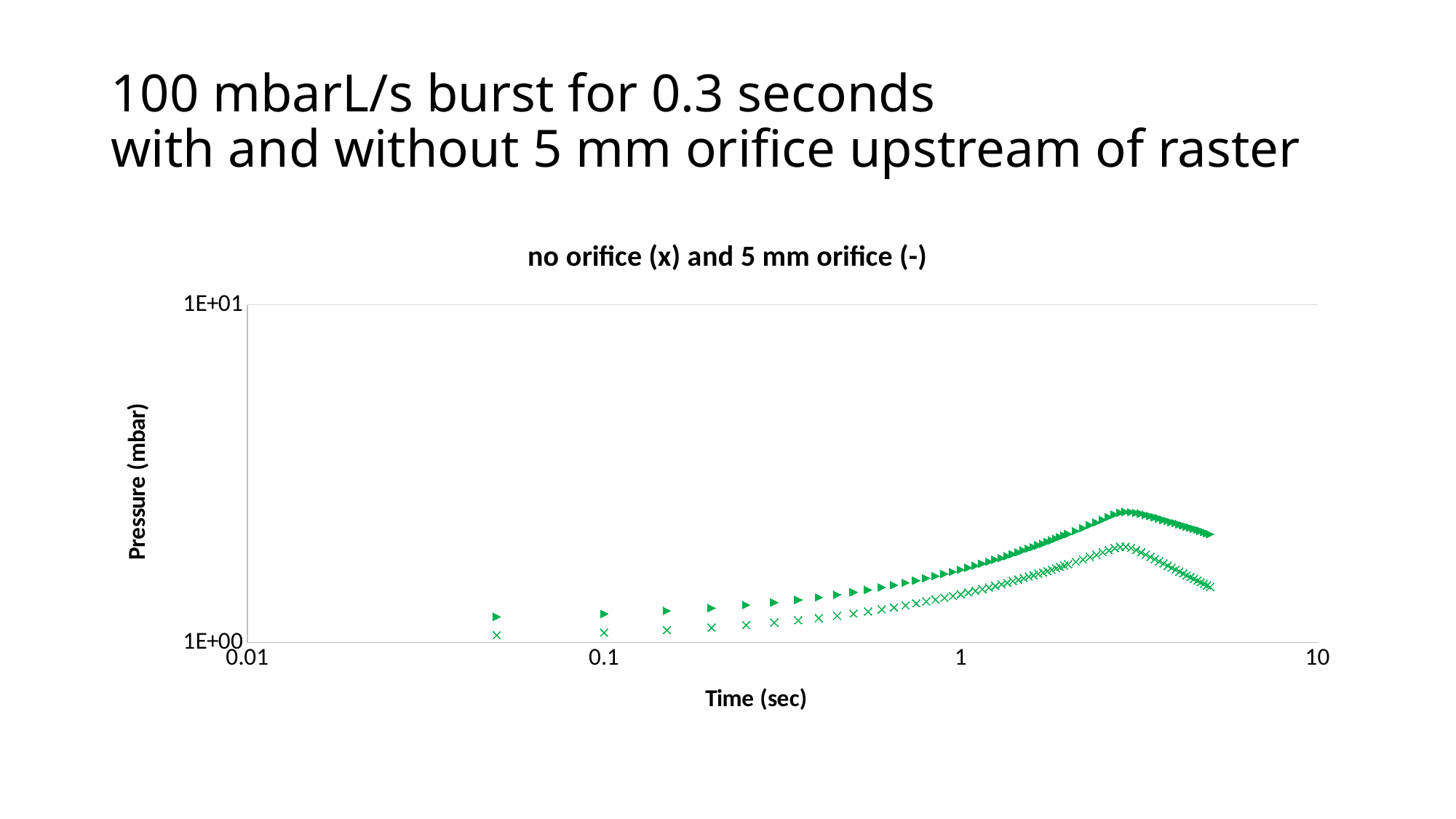
After the peak near 3 sec, do the pressure values of the no orifice series rise or fall? fall At 1 sec, which series shows the higher pressure, no orifice or 5 mm orifice? 5 mm orifice Is the peak pressure of the 5 mm orifice series greater or less than 1E+01 mbar? less Is the pressure of the 5 mm orifice series at 0.1 sec greater or less than 1E+01 mbar? less What kind of chart is shown on the slide? scatter chart What is the label of the vertical axis of the chart? Pressure (mbar) How many data series are plotted on the chart? 2 Between 0.1 sec and 1 sec, do the pressure values of the 5 mm orifice series rise or fall? rise Which series reaches a higher peak pressure, the no orifice series or the 5 mm orifice series? 5 mm orifice Is the pressure of the no orifice series at 1 sec greater or less than 1E+00 mbar? greater What is the title of the chart? no orifice (x) and 5 mm orifice (-)